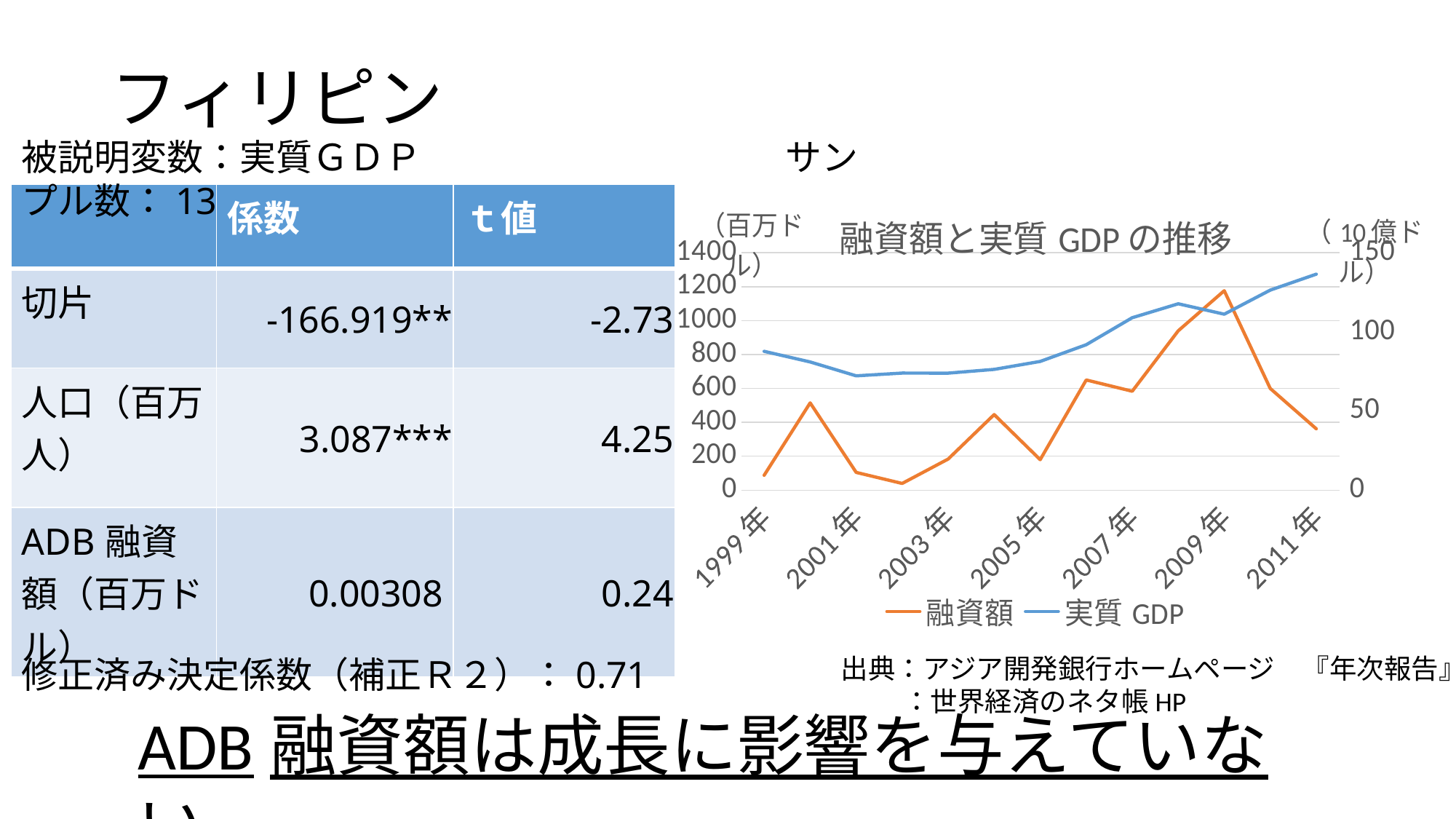
In which year does the 融資額 line reach its highest value? 2009年 What is the title of the chart? 融資額と実質GDPの推移 Which series is drawn in orange in the chart? 融資額 Is the value of 融資額 in 1999年 greater or less than 200? less Is the value of 実質GDP in 2011年 greater or less than 100 on the right axis? greater Is the value of 実質GDP in 1999年 greater or less than 100 on the right axis? less Which is larger for 融資額: the value in 2009年 or the value in 2011年? 2009年 Does the 実質GDP line generally rise or fall from 2003年 to 2011年? rise How many series does the chart's legend list? 2 How many data points does each line in the chart have? 13 What kind of chart is shown on the slide? line chart